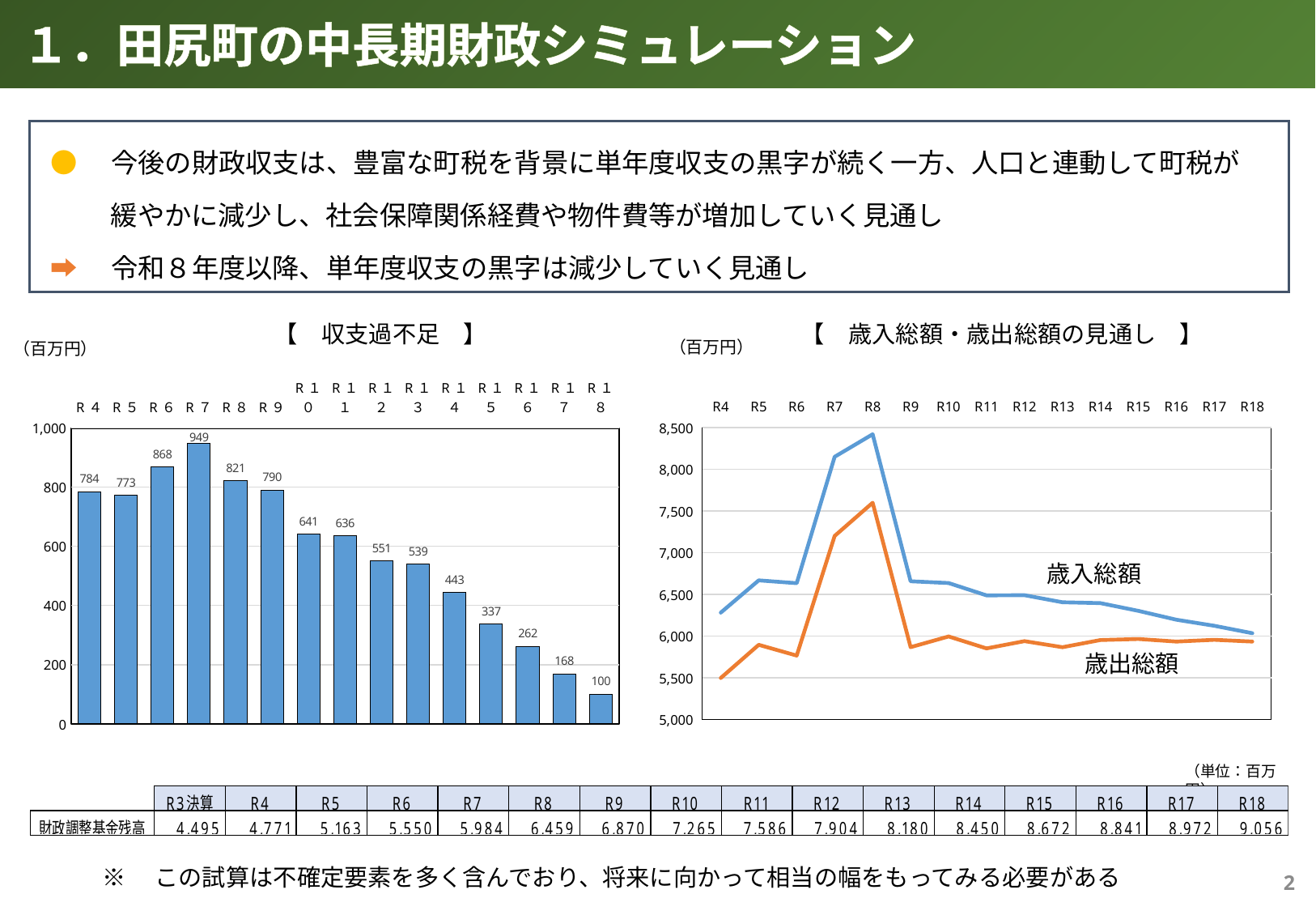
In the 収支過不足 chart, what is the difference between the values for R7 and R18? 849 In the 歳入総額・歳出総額の見通し chart, is the value of 歳出総額 for R4 greater or less than 6,000? less In the 収支過不足 chart, what is the value for R18? 100 In the 収支過不足 chart, what is the value for R7? 949 In the 歳入総額・歳出総額の見通し chart, is the value of 歳入総額 for R8 greater or less than 8,000? greater What kind of chart is the 収支過不足 chart? bar chart How many series are plotted in the 歳入総額・歳出総額の見通し chart? 2 In the 収支過不足 chart, which year has the lowest value? R18 In the 収支過不足 chart, what is the value for R12? 551 How many bars are shown in the 収支過不足 chart? 15 In the 収支過不足 chart, which year has the highest value? R7 In the 収支過不足 chart, which is larger, the value for R4 or the value for R8? R8